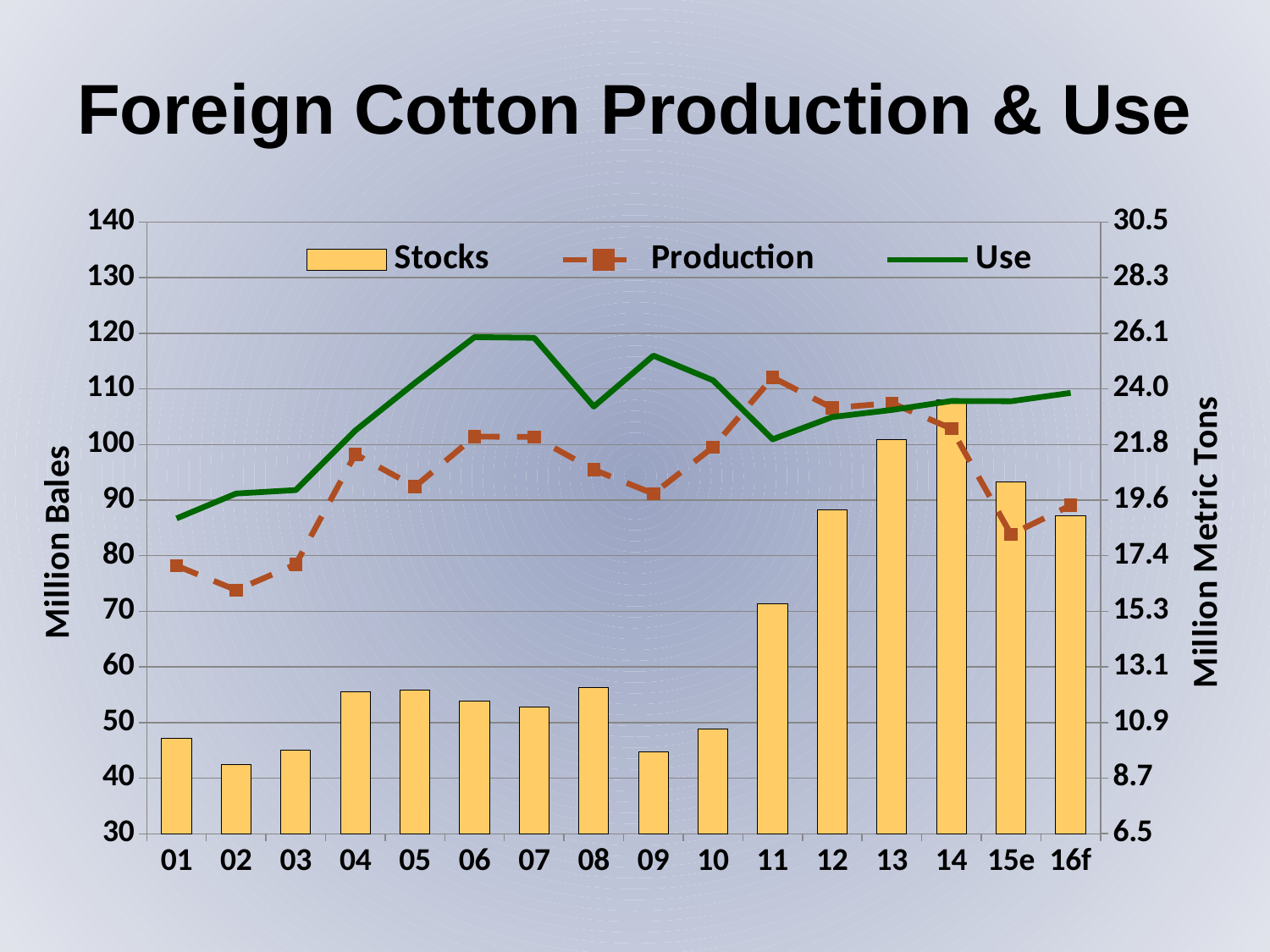
Is the Stocks value for 14 greater or less than 100 million bales? greater What is the label on the right-hand vertical axis? Million Metric Tons Which year has the highest Stocks bar? 14 How many series does the legend list? 3 Which year has the larger Stocks bar, 11 or 12? 12 What is the title of the chart? Foreign Cotton Production & Use Is the Stocks value for 02 greater or less than 50 million bales? less How many years (categories) are shown on the x axis? 16 What kind of chart is shown on the slide? A combination bar and line chart Which year has the lowest Stocks bar? 02 Do the Stocks bars rise or fall from 10 to 14? Rise Is the Stocks value for 12 greater or less than 80 million bales? greater